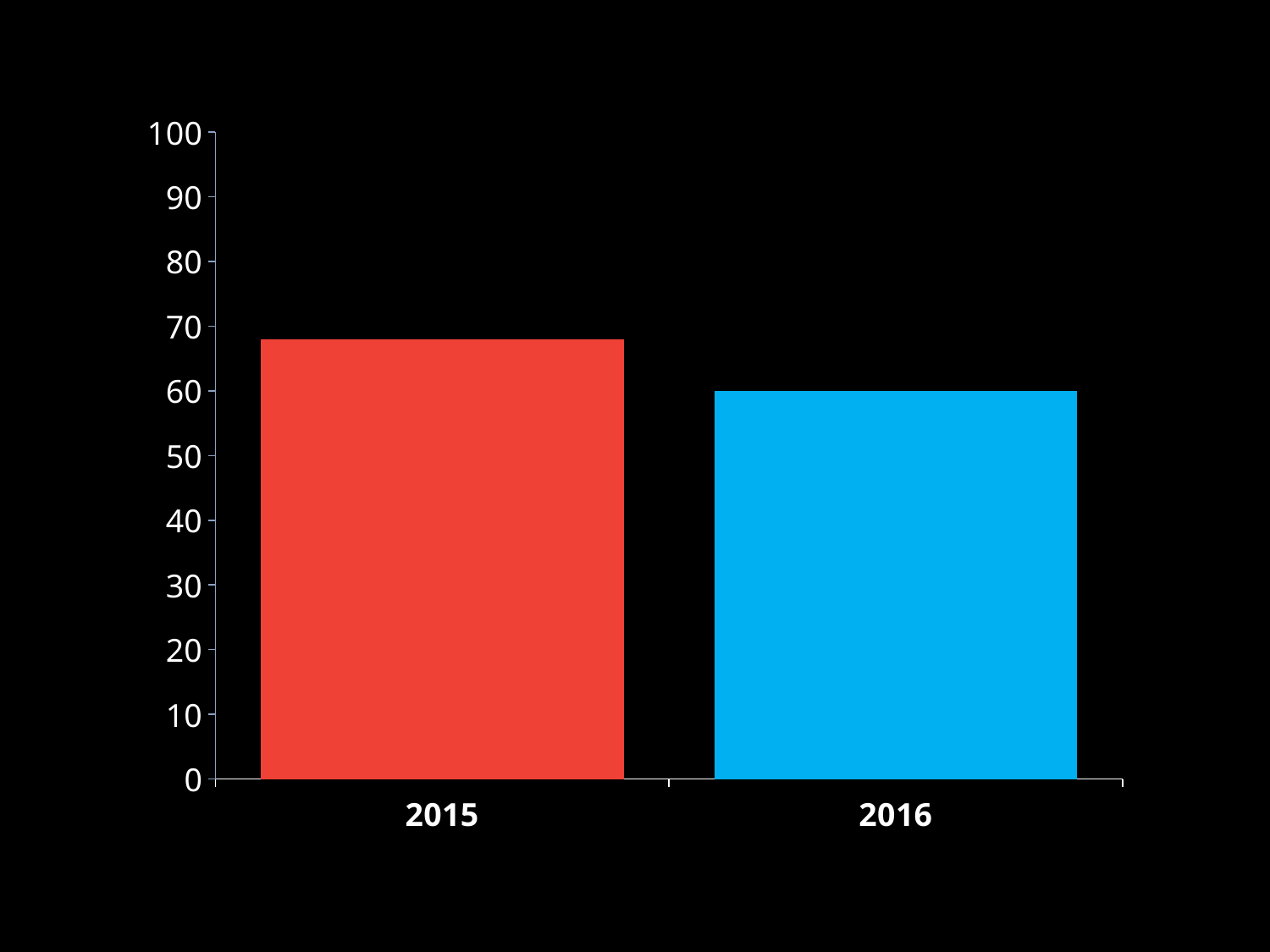
What colour is the bar for 2015? red Which year has the highest bar? 2015 Which is larger, the value for 2015 or the value for 2016? 2015 Is the value for 2015 greater or less than 60? greater What colour is the bar for 2016? blue What is the value for 2016? 60 Which year has the lowest bar? 2016 Is the value for 2015 greater or less than 70? less Do the values rise or fall from 2015 to 2016? fall What kind of chart is shown on the slide? bar chart How many categories are shown on the x axis? 2 Is the value for 2016 greater or less than 70? less